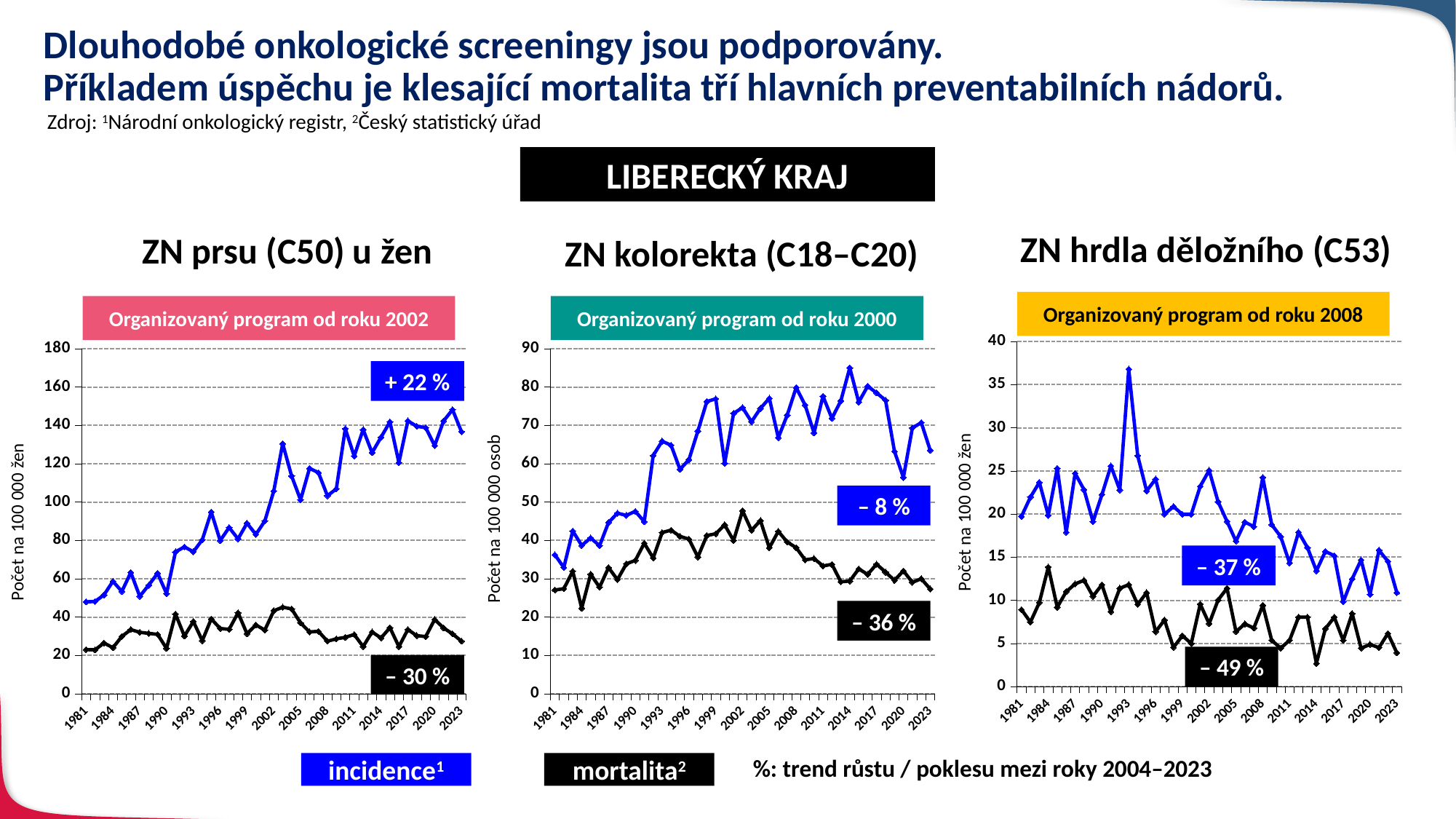
What kind of chart is used for ZN prsu (C50) u žen? line chart In the ZN prsu (C50) u žen chart, does the incidence line generally rise or fall from 1981 to 2023? rise In the ZN hrdla děložního (C53) chart, which series is higher in 2023, incidence or mortalita? incidence In the ZN prsu (C50) u žen chart, what trend percentage is shown for mortalita? – 30 % In the ZN kolorekta (C18–C20) chart, what trend percentage is shown for mortalita? – 36 % In the ZN prsu (C50) u žen chart, what trend percentage is shown for incidence? + 22 % In the ZN prsu (C50) u žen chart, is the incidence value for 2023 greater or less than 120? greater In the ZN kolorekta (C18–C20) chart, what trend percentage is shown for incidence? – 8 % In the ZN kolorekta (C18–C20) chart, is the mortalita value for 2023 greater or less than 40? less According to the banner above the ZN kolorekta (C18–C20) chart, since which year has the organized program run? 2000 How many series does the legend at the bottom of the slide list? 2 In the ZN hrdla děložního (C53) chart, what trend percentage is shown for mortalita? – 49 %